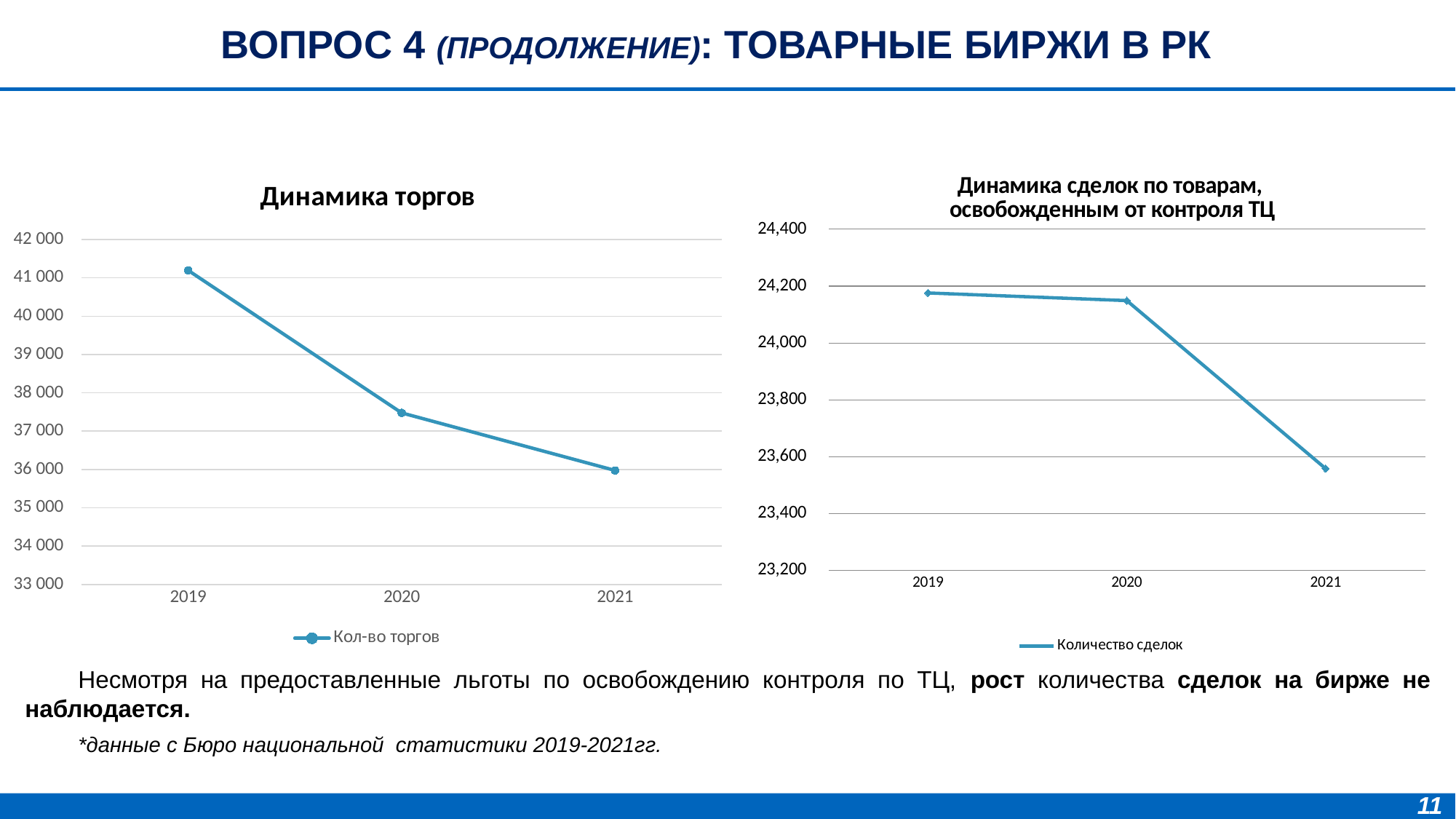
In the "Динамика торгов" chart, do the values rise or fall from 2019 to 2021? fall What kind of chart is the "Динамика торгов" chart? line chart In the "Динамика сделок по товарам, освобожденным от контроля ТЦ" chart, is the value for 2021 greater or less than 23,800? less How many years are plotted in the "Динамика торгов" chart? 3 In the "Динамика торгов" chart, which year has the highest value? 2019 In the "Динамика сделок по товарам, освобожденным от контроля ТЦ" chart, which year has the lowest value? 2021 In the "Динамика торгов" chart, is the value for 2019 greater or less than 40 000? greater In the "Динамика торгов" chart, is the value for 2021 greater or less than 37 000? less In the "Динамика сделок по товарам, освобожденным от контроля ТЦ" chart, which is larger, the value for 2020 or the value for 2021? 2020 What is the legend entry in the "Динамика торгов" chart? Кол-во торгов How many series does the legend of the "Динамика сделок по товарам, освобожденным от контроля ТЦ" chart list? 1 In the "Динамика торгов" chart, which year has the lowest value? 2021